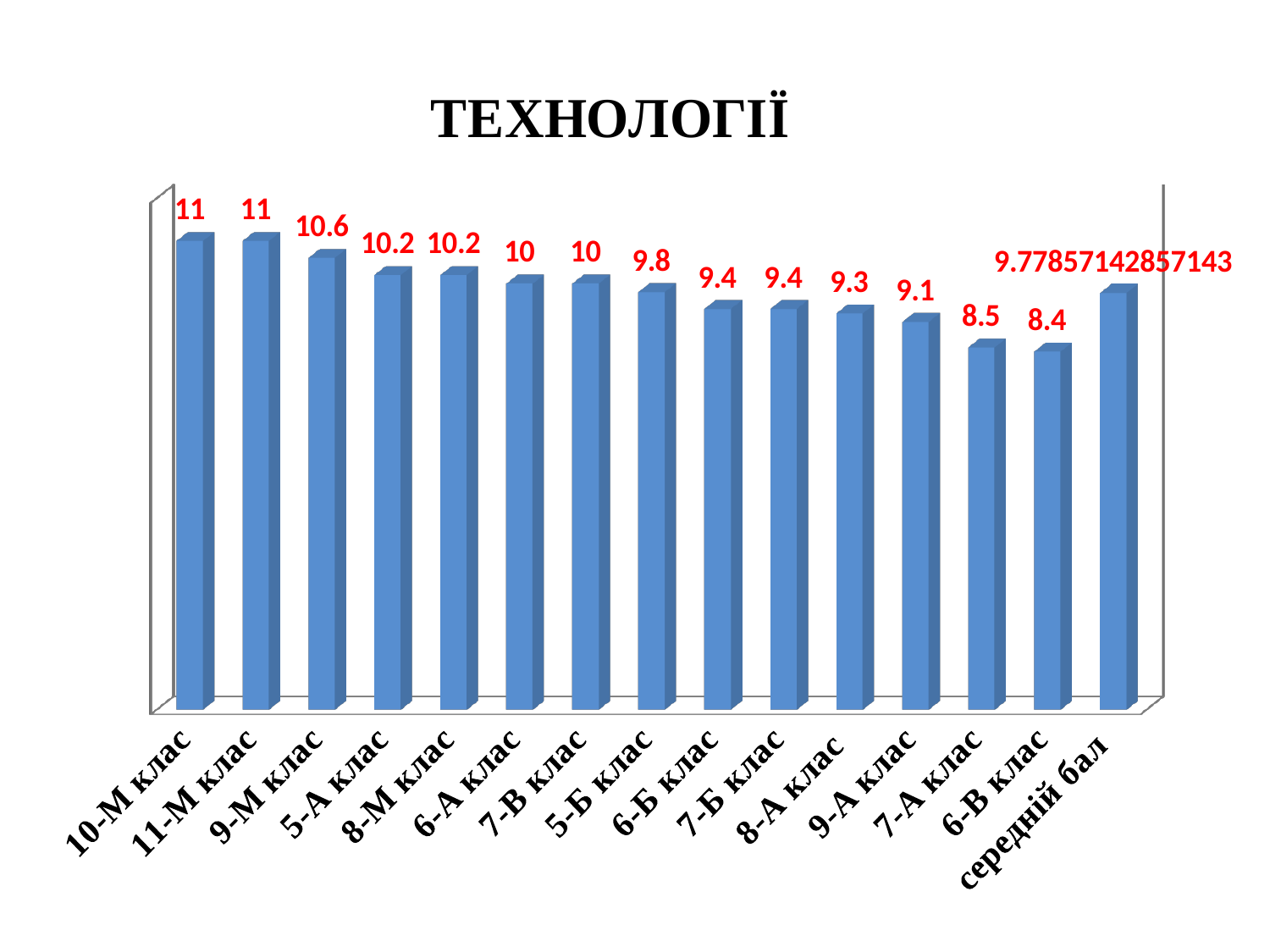
What is the title of the chart? ТЕХНОЛОГІЇ What kind of chart is shown on the slide? Bar chart Which is larger, the value for 6-Б клас or the value for 11-М клас? 11-М клас How many bars are shown in the chart? 15 What is the difference between the values for 10-М клас and 6-В клас? 2.6 What is the value for 9-М клас? 10.6 Which is larger, the value for 5-А клас or the value for 8-А клас? 5-А клас Which category has the lowest value? 6-В клас What is the difference between the values for 9-М клас and 9-А клас? 1.5 What value is shown for середній бал? 9.77857142857143 What is the value for 5-Б клас? 9.8 What is the value for 7-А клас? 8.5